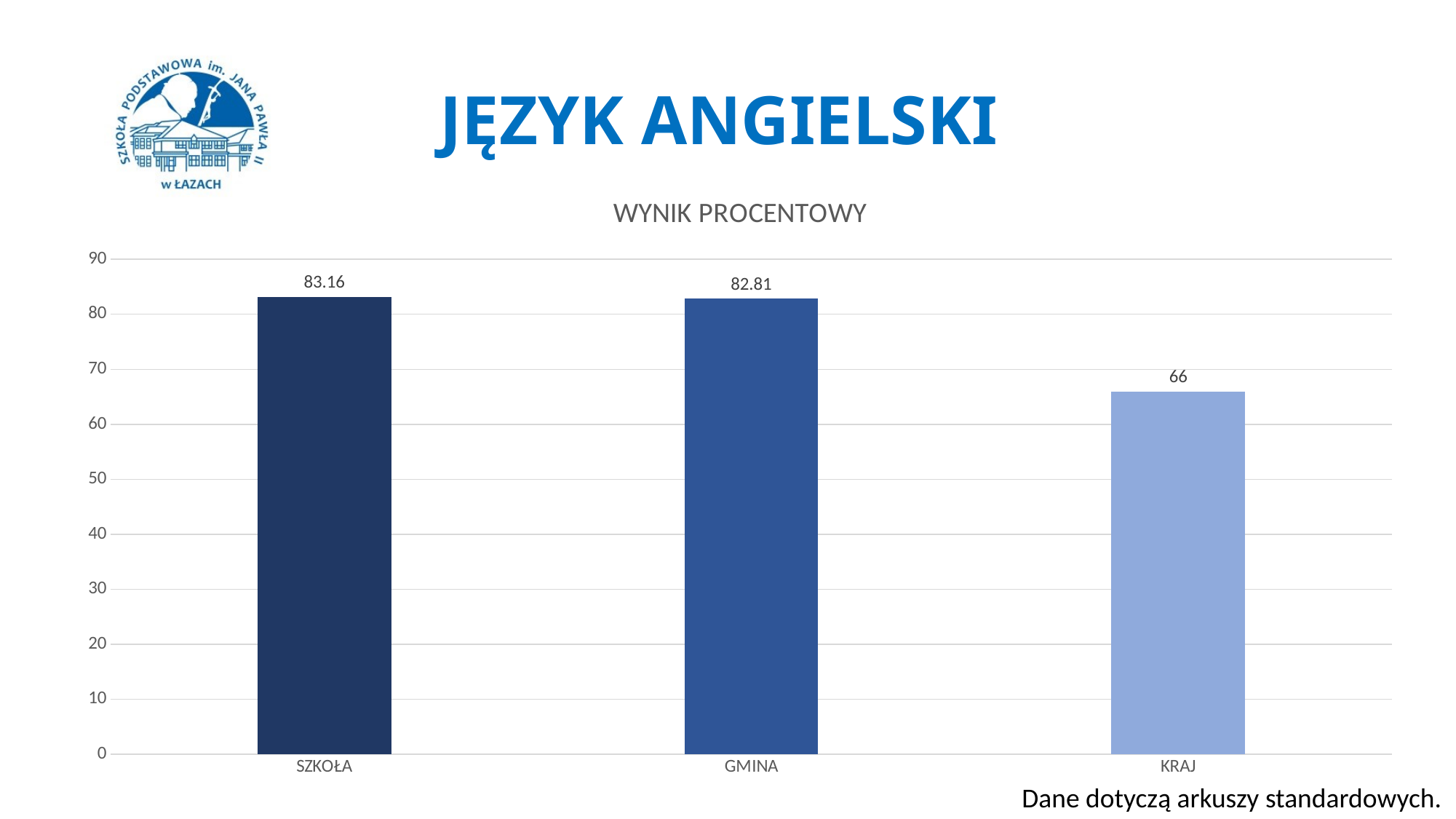
What is the value for GMINA? 82.81 What is the difference between the values for GMINA and KRAJ? 16.81 Is the value for SZKOŁA greater or less than 80? greater What kind of chart is shown on the slide? bar chart Is the value for KRAJ greater or less than 70? less What is the value for SZKOŁA? 83.16 How many categories are shown in the chart? 3 Which is larger, the value for GMINA or the value for KRAJ? GMINA Which category has the lowest value? KRAJ What is the difference between the values for SZKOŁA and KRAJ? 17.16 What is the value for KRAJ? 66 What is the title of the chart? WYNIK PROCENTOWY